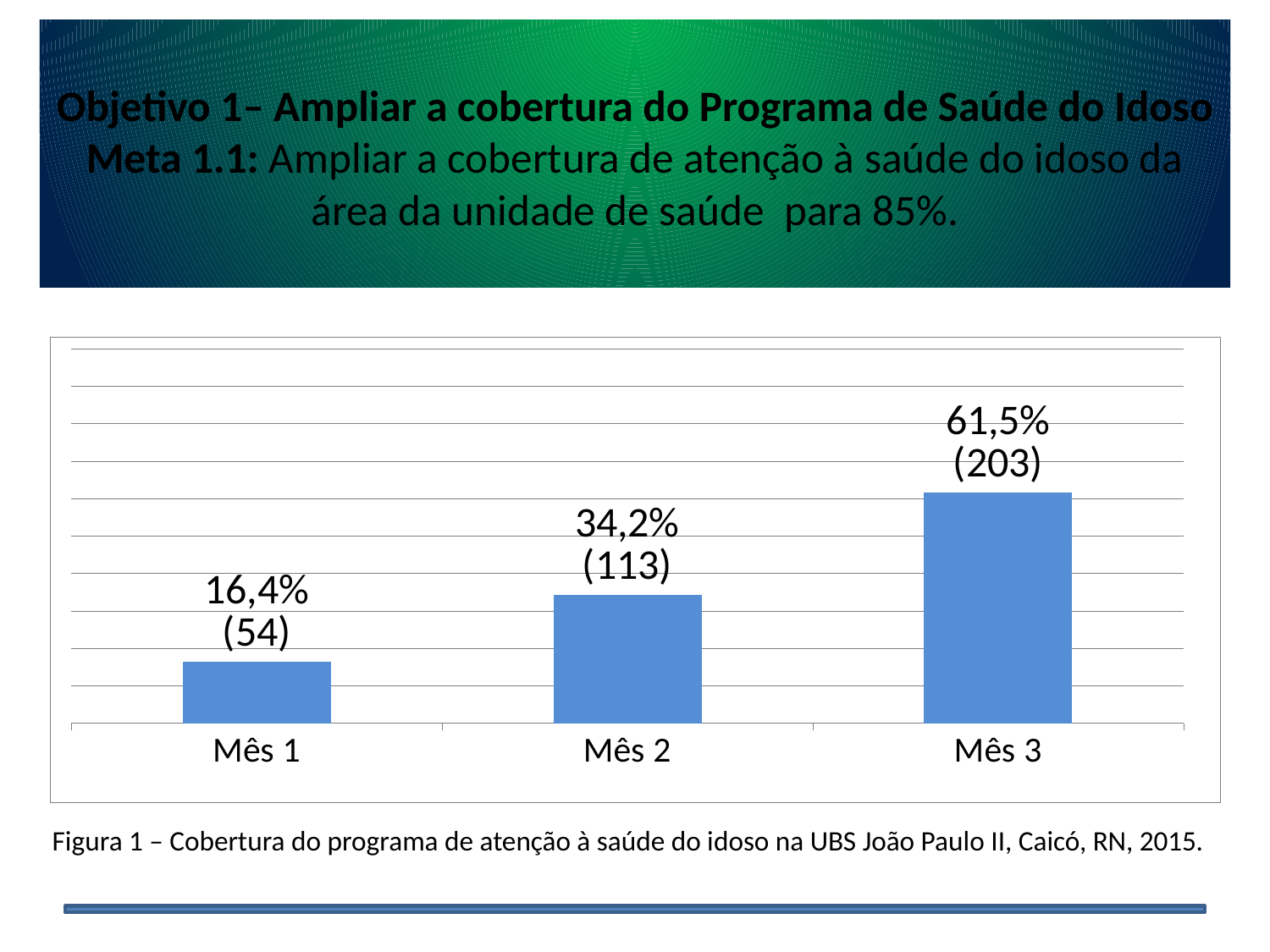
How many months are shown on the x axis? 3 Do the values rise or fall from Mês 1 to Mês 3? Rise What is the data label shown for Mês 1? 16,4% (54) According to the caption, in which city and state was the data collected? Caicó, RN What is the difference between the number in parentheses for Mês 3 and for Mês 1? 149 Which is larger, the value for Mês 2 or the value for Mês 3? Mês 3 What number in parentheses is shown for Mês 3? 203 What kind of chart is shown on the slide? Bar chart What is the difference in percentage points between Mês 2 and Mês 1? 17,8 Which month has the lowest coverage? Mês 1 Which month has the highest coverage? Mês 3 What percentage coverage is shown for Mês 2? 34,2%